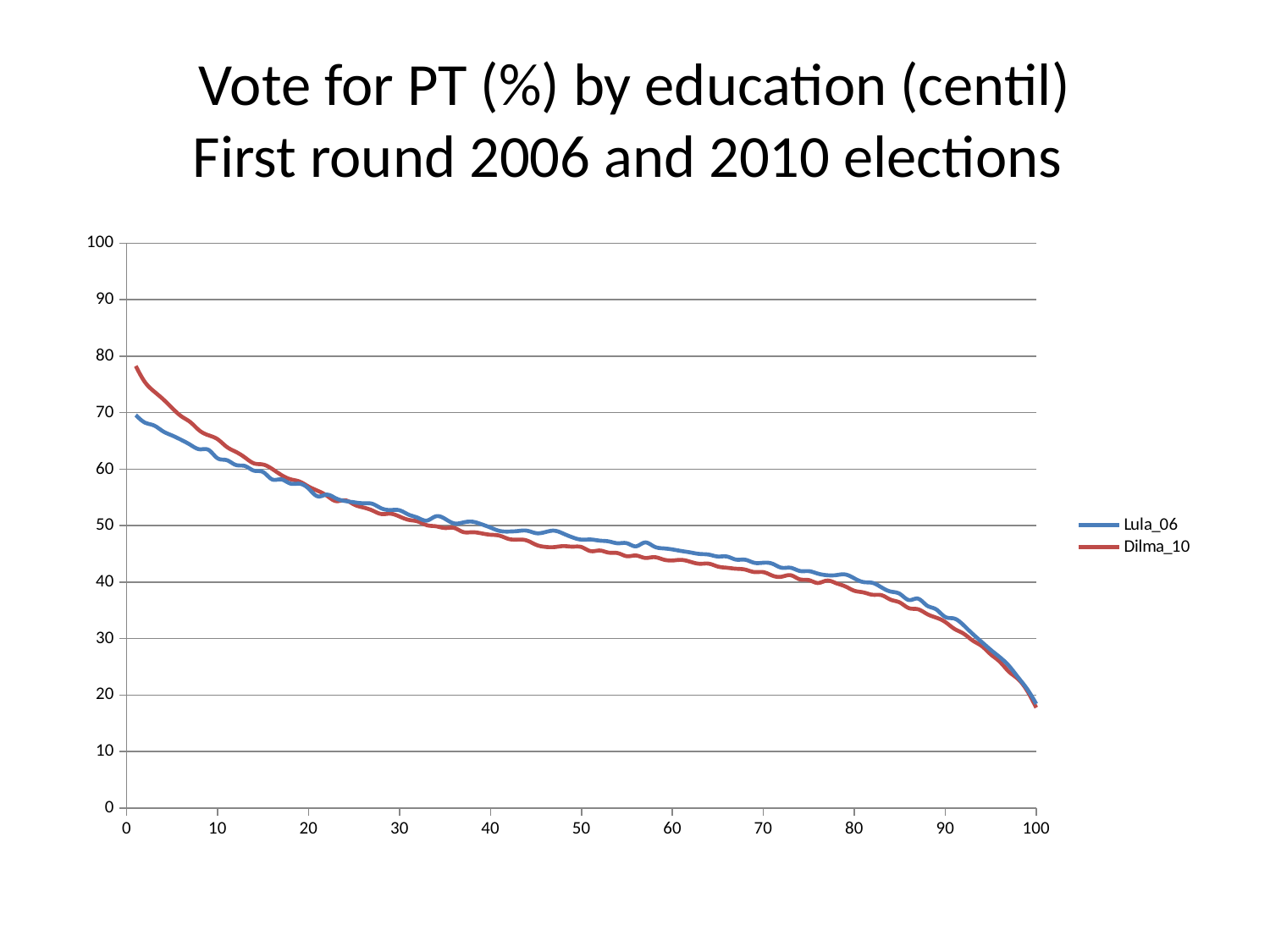
What is the title of the chart? Vote for PT (%) by education (centil) First round 2006 and 2010 elections Do the values for Lula_06 rise or fall as the education centil increases along the x axis? fall At centil 60, which series has the higher value, Lula_06 or Dilma_10? Lula_06 Is the value for Dilma_10 at centil 1 greater or less than 70? greater What are the two series named in the legend? Lula_06 and Dilma_10 What kind of chart is shown on the slide? line chart Do the values for Dilma_10 rise or fall as the education centil increases along the x axis? fall Is the value for Lula_06 at centil 1 greater or less than 80? less Is the value for Lula_06 at centil 90 greater or less than 40? less At centil 5, which series has the higher value, Lula_06 or Dilma_10? Dilma_10 How many series does the legend list? 2